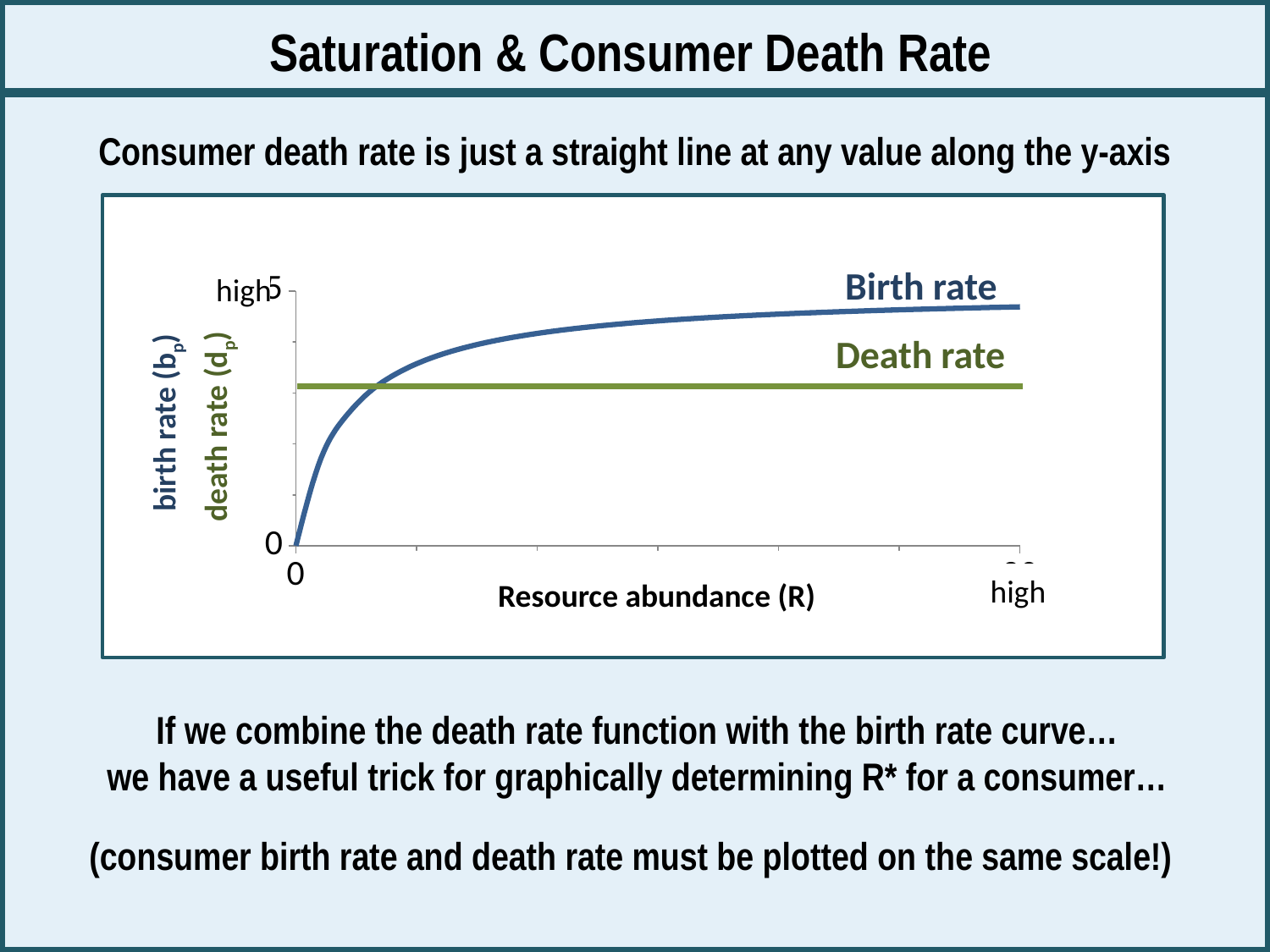
At very low resource abundance (near R = 0), which is larger: the birth rate or the death rate? Death rate How many series are plotted on the chart? 2 What colour is the Death rate line? Green How does the death rate change as resource abundance (R) increases? It stays constant At high resource abundance, which is larger: the birth rate or the death rate? Birth rate Is the death rate value greater or less than 5 on the y-axis? less What is the label of the x-axis? Resource abundance (R) What is the highest tick value shown on the y-axis? 5 What is the lowest tick value shown on the x-axis? 0 What kind of chart is shown on the slide? Line chart How does the birth rate change as resource abundance (R) increases? It rises and then levels off Which two series are labelled on the chart? Birth rate and Death rate